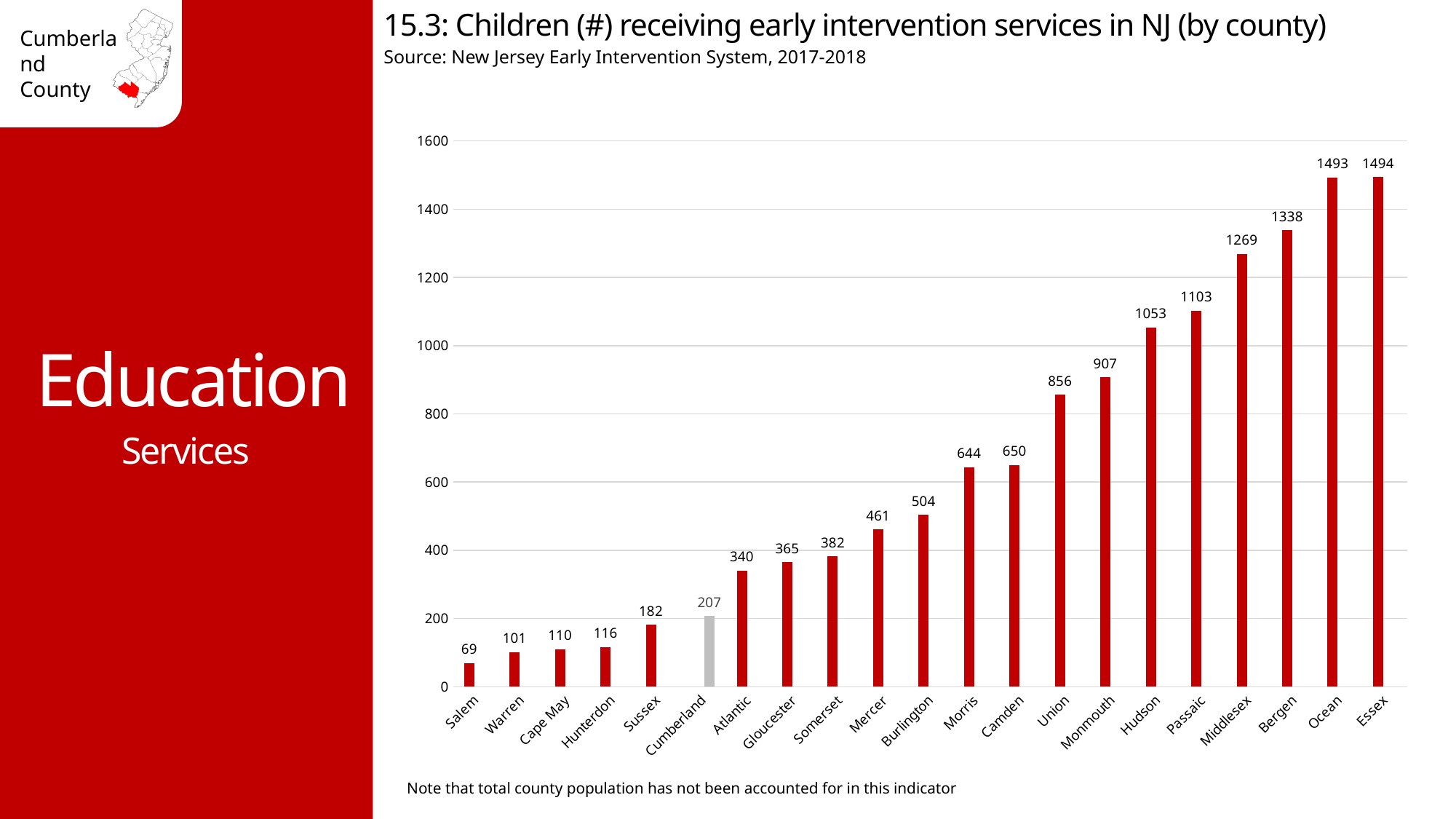
What is the difference between the values for Cumberland and Salem? 138 What is the value shown for Atlantic County? 340 How many children received early intervention services in Cumberland County? 207 What kind of chart is shown on the slide? Bar chart What is the value shown for Hudson County? 1053 What is the difference between the values for Bergen and Middlesex? 69 Do the values rise or fall moving from left to right along the x axis? Rise How many counties are shown on the chart? 21 Is the value for Union greater or less than 800? greater Which county has the lowest number of children receiving early intervention services? Salem Which county's bar is coloured grey instead of red? Cumberland Which county has a higher value, Monmouth or Union? Monmouth